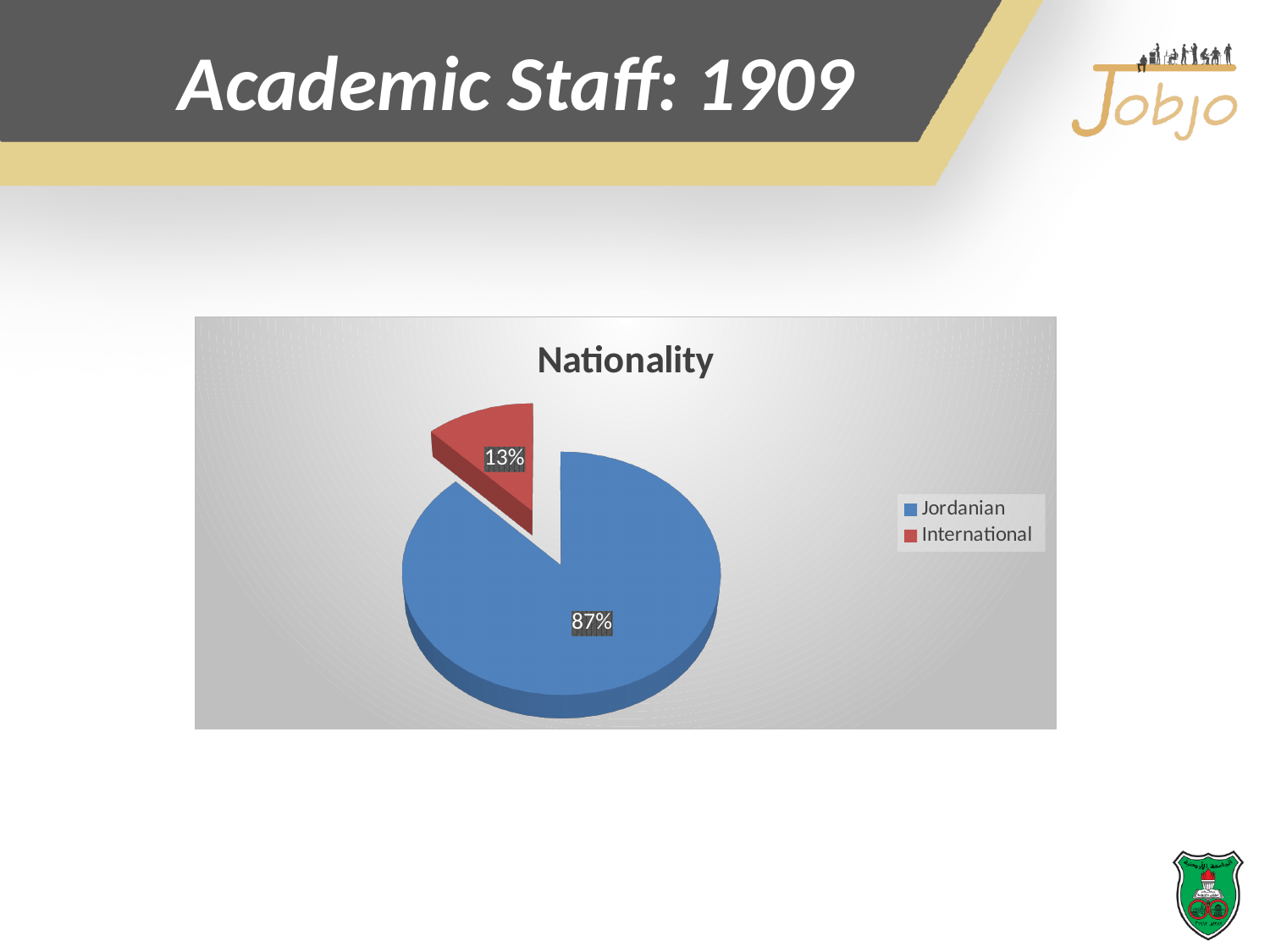
What is the difference in percentage points between the Jordanian and International slices? 74 Which is larger, the Jordanian slice or the International slice? Jordanian What colour is the International slice? Red How many entries does the legend list? 2 What share of the pie is International? 13% Which category has the largest slice of the pie? Jordanian What share of the pie is Jordanian? 87% What type of chart is shown on the slide? Pie chart What is the title of the chart? Nationality How many categories does the pie chart show? 2 Which category has the smallest slice of the pie? International